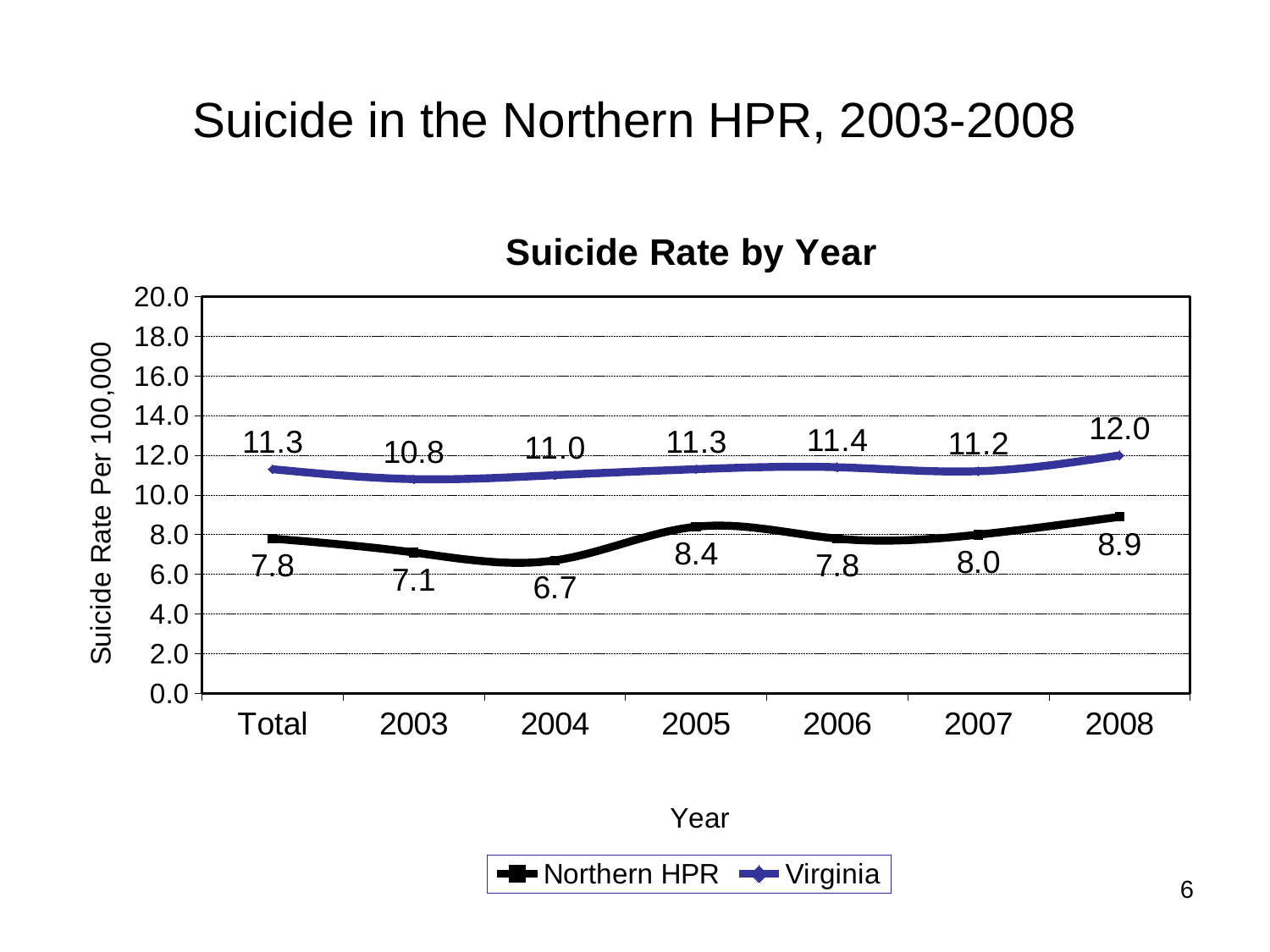
What is the Northern HPR suicide rate for the Total category? 7.8 What is the Northern HPR suicide rate for 2004? 6.7 How many series does the legend list? 2 In which year is the Northern HPR suicide rate highest? 2008 What is the title of the chart? Suicide Rate by Year How many categories are shown on the x axis? 7 What is the difference between the Virginia and Northern HPR suicide rates in 2006? 3.6 Which series has the higher suicide rate in 2005, Northern HPR or Virginia? Virginia Is the Northern HPR suicide rate for 2007 greater or less than 10.0? less In which year is the Virginia suicide rate lowest? 2003 What kind of chart is shown on the slide? line chart What is the Virginia suicide rate for 2008? 12.0